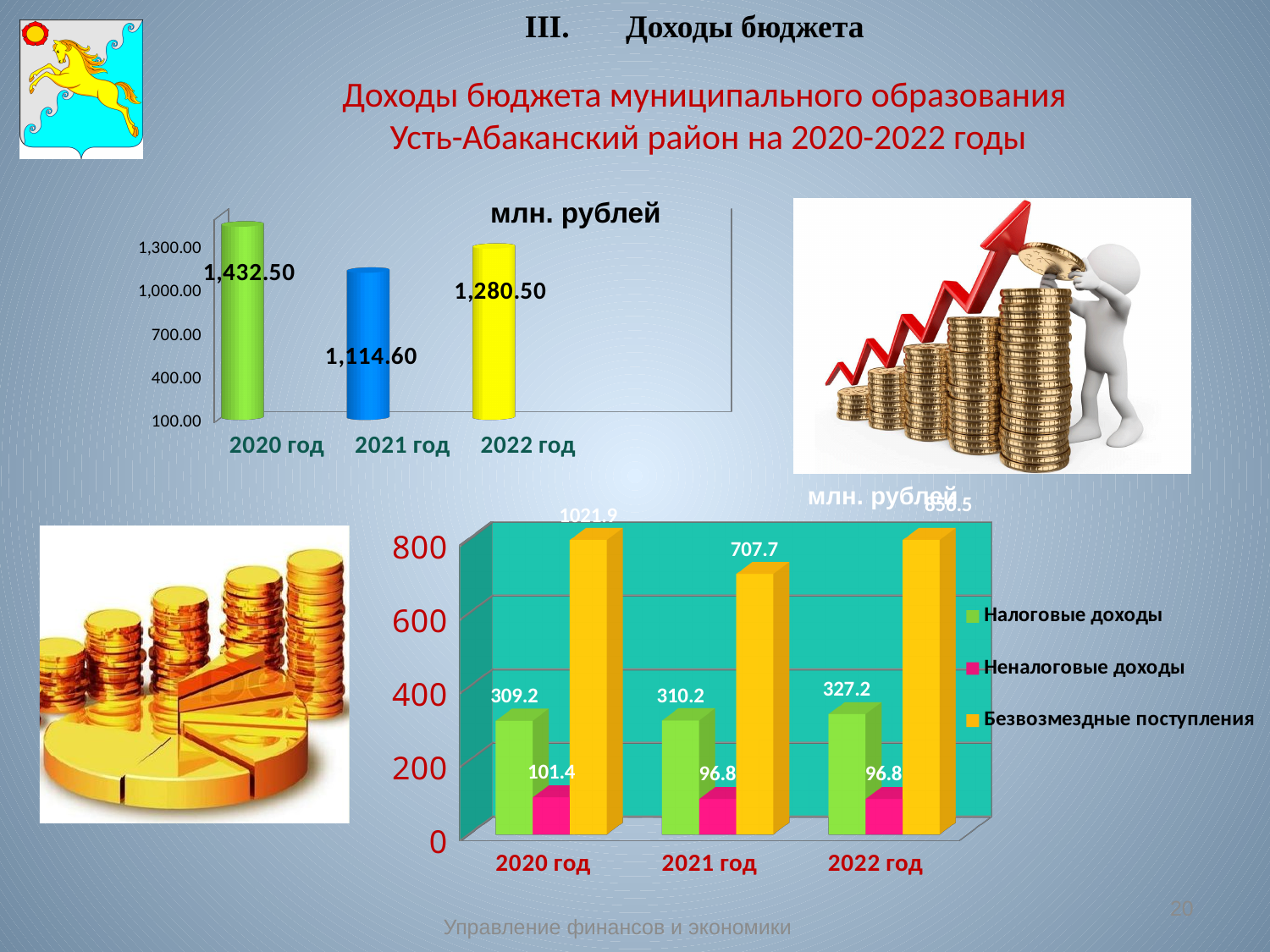
In the bottom chart, what is the difference between Безвозмездные поступления for 2020 год and 2021 год? 314.2 In the bottom chart, how many series does the legend list? 3 In the top-left chart, what is the value for 2020 год? 1,432.50 In the top-left chart, how many years are shown on the x axis? 3 In the top-left chart, which year has the highest value? 2020 год In the bottom chart, what is the value of Налоговые доходы for 2022 год? 327.2 In the top-left chart, what is the value for 2021 год? 1,114.60 In the bottom chart, which is larger: Неналоговые доходы for 2020 год or for 2021 год? 2020 год In the top-left chart, which year has the lowest value? 2021 год In the top-left chart, what is the difference between the values for 2020 год and 2022 год? 152.00 What type of chart is the top-left chart? bar chart In the bottom chart, what is the value of Безвозмездные поступления for 2021 год? 707.7